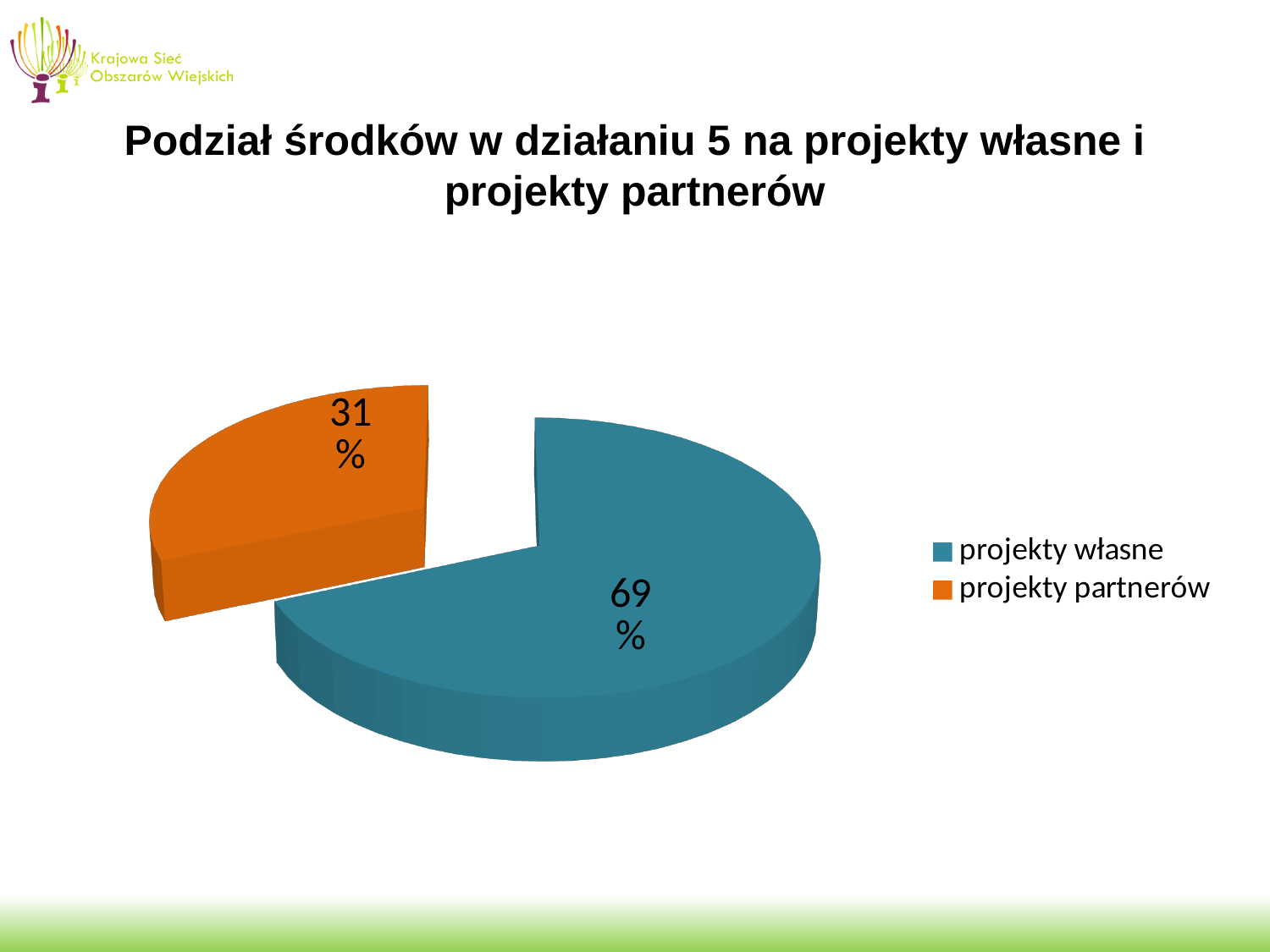
What colour is the slice for 'projekty partnerów'? orange How many entries does the legend list? 2 Which category has the smallest slice of the pie? projekty partnerów What is the difference in percentage points between 'projekty własne' and 'projekty partnerów'? 38 What kind of chart is shown on the slide? pie chart How many slices does the pie chart have? 2 Which category has the largest slice of the pie? projekty własne Which is larger, the share for 'projekty własne' or for 'projekty partnerów'? projekty własne What is the title of the chart? Podział środków w działaniu 5 na projekty własne i projekty partnerów What share of the pie does 'projekty własne' represent? 69% What share of the pie does 'projekty partnerów' represent? 31%